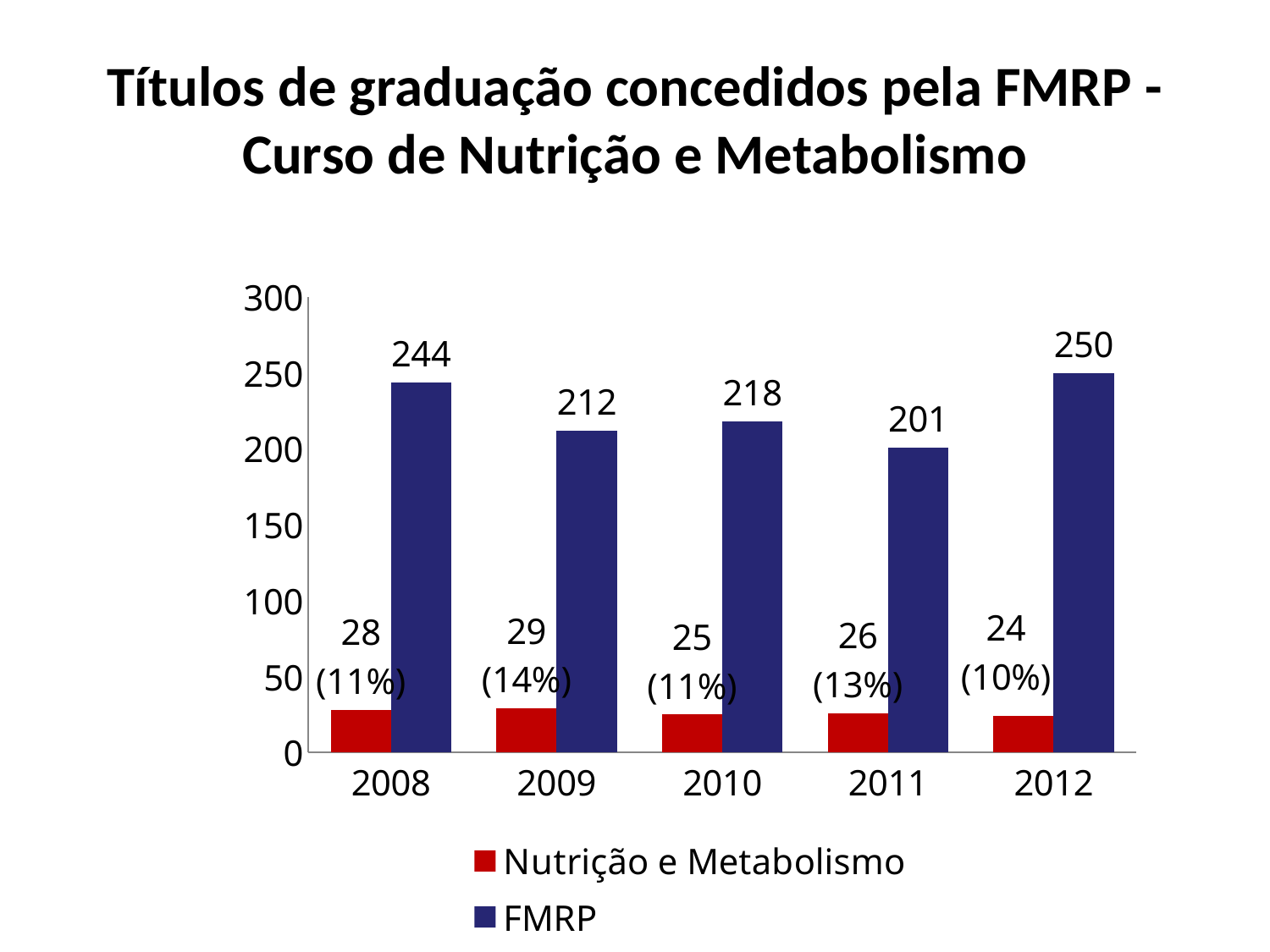
What is the FMRP value for 2012? 250 What is the difference between the FMRP values for 2012 and 2011? 49 In which year is the FMRP value lowest? 2011 How many years are shown on the x axis? 5 How many series does the legend list? 2 What kind of chart is shown on the slide? Bar chart Is the FMRP value for 2009 greater or less than 200? greater In which year is the Nutrição e Metabolismo value lowest? 2012 In which year is the FMRP value highest? 2012 What is the FMRP value for 2011? 201 What is the Nutrição e Metabolismo value for 2009? 29 (14%) Which is larger, the FMRP value for 2008 or for 2010? 2008